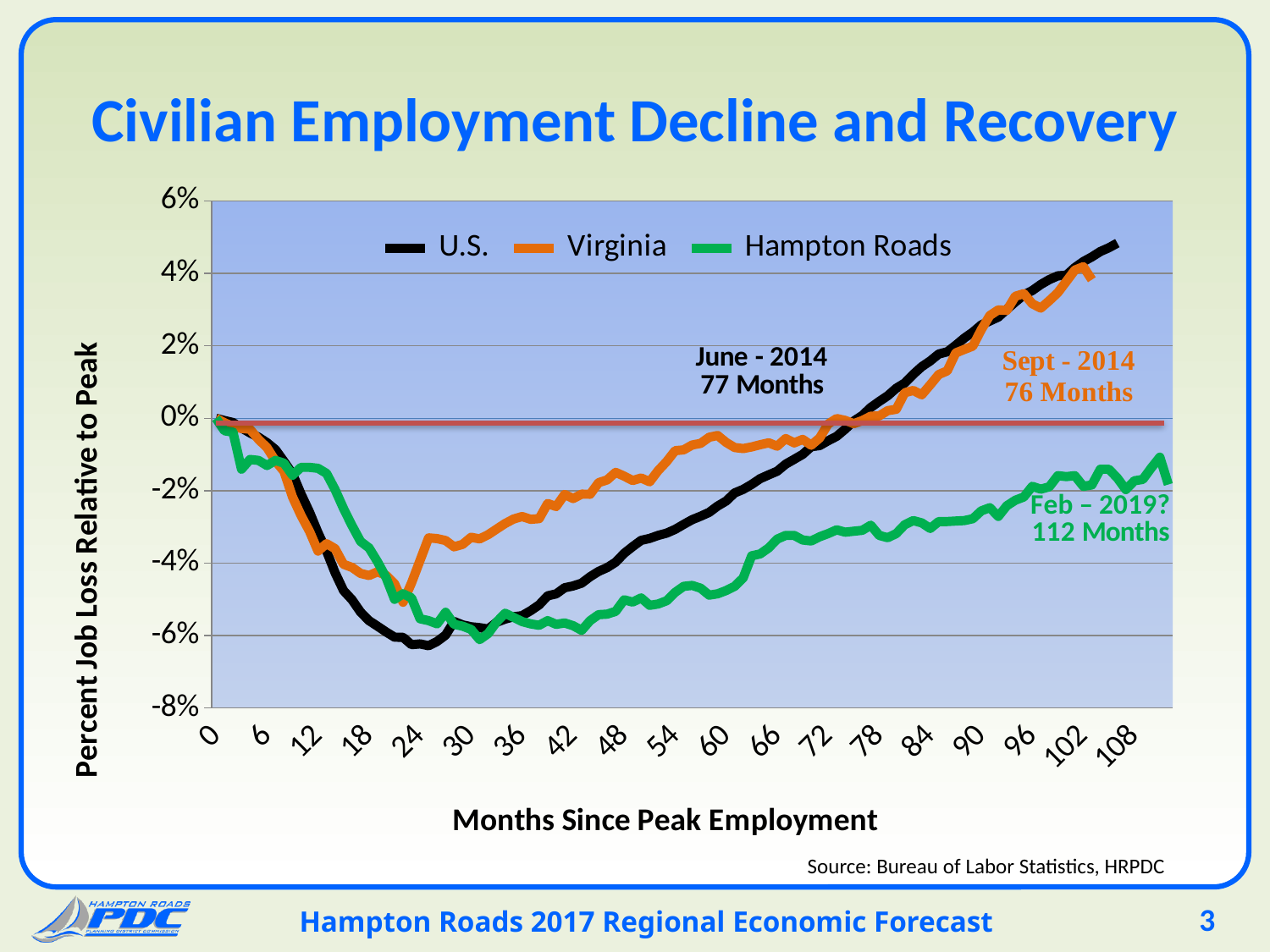
According to the annotation on the chart, in what month and year did Virginia return to peak employment? Sept - 2014 According to the annotation on the chart, how many months did it take the U.S. to return to peak employment? 77 Months Is the value for Hampton Roads at month 36 greater or less than -4%? less What are the three series named in the chart's legend? U.S., Virginia, Hampton Roads According to the annotation on the chart, how many months is Hampton Roads projected to take to return to peak employment? 112 Months What is the label on the chart's x axis? Months Since Peak Employment Which series is lowest at month 108? Hampton Roads What kind of chart is shown on the slide? Line chart How many series does the chart's legend list? 3 Does the U.S. line rise or fall between month 30 and month 108? rise